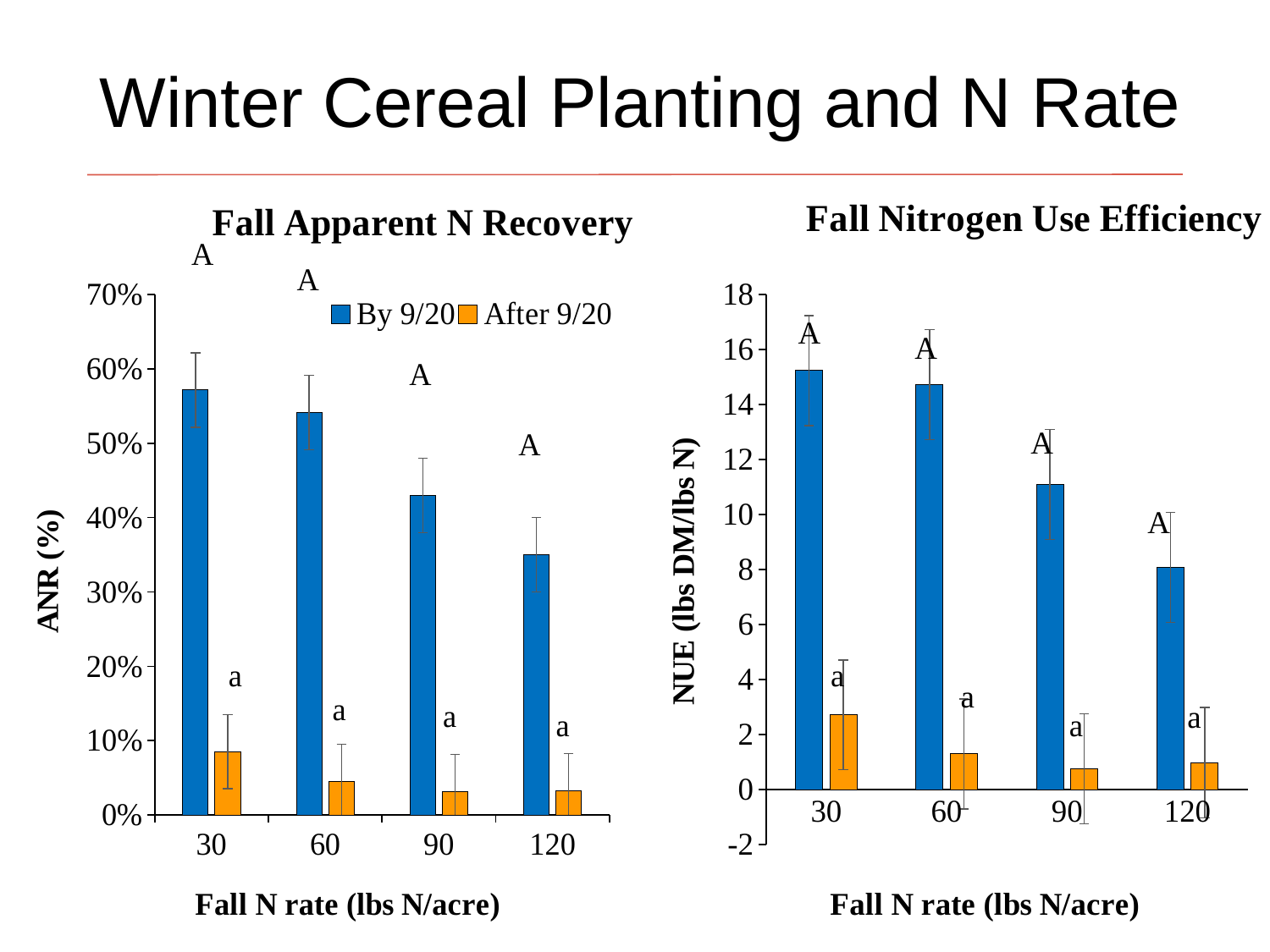
How many series does the legend on the Fall Apparent N Recovery chart list? 2 In the Fall Nitrogen Use Efficiency chart, at a Fall N rate of 30, which series has the larger value, By 9/20 or After 9/20? By 9/20 In the Fall Apparent N Recovery chart, is the By 9/20 value at a Fall N rate of 120 greater or less than 40%? less In the Fall Apparent N Recovery chart, do the By 9/20 values rise or fall as the Fall N rate increases? fall In the Fall Nitrogen Use Efficiency chart, is the By 9/20 value at a Fall N rate of 90 greater or less than 10? greater In the Fall Apparent N Recovery chart, is the By 9/20 value at a Fall N rate of 30 greater or less than 50%? greater In the Fall Apparent N Recovery chart, at which Fall N rate is the By 9/20 bar highest? 30 What is the y-axis label of the Fall Nitrogen Use Efficiency chart? NUE (lbs DM/lbs N) How many Fall N rate categories are shown on the Fall Nitrogen Use Efficiency chart? 4 In the Fall Nitrogen Use Efficiency chart, at which Fall N rate is the By 9/20 bar lowest? 120 What kind of chart is the Fall Apparent N Recovery chart? bar chart In the Fall Apparent N Recovery chart, at which Fall N rate is the By 9/20 bar lowest? 120